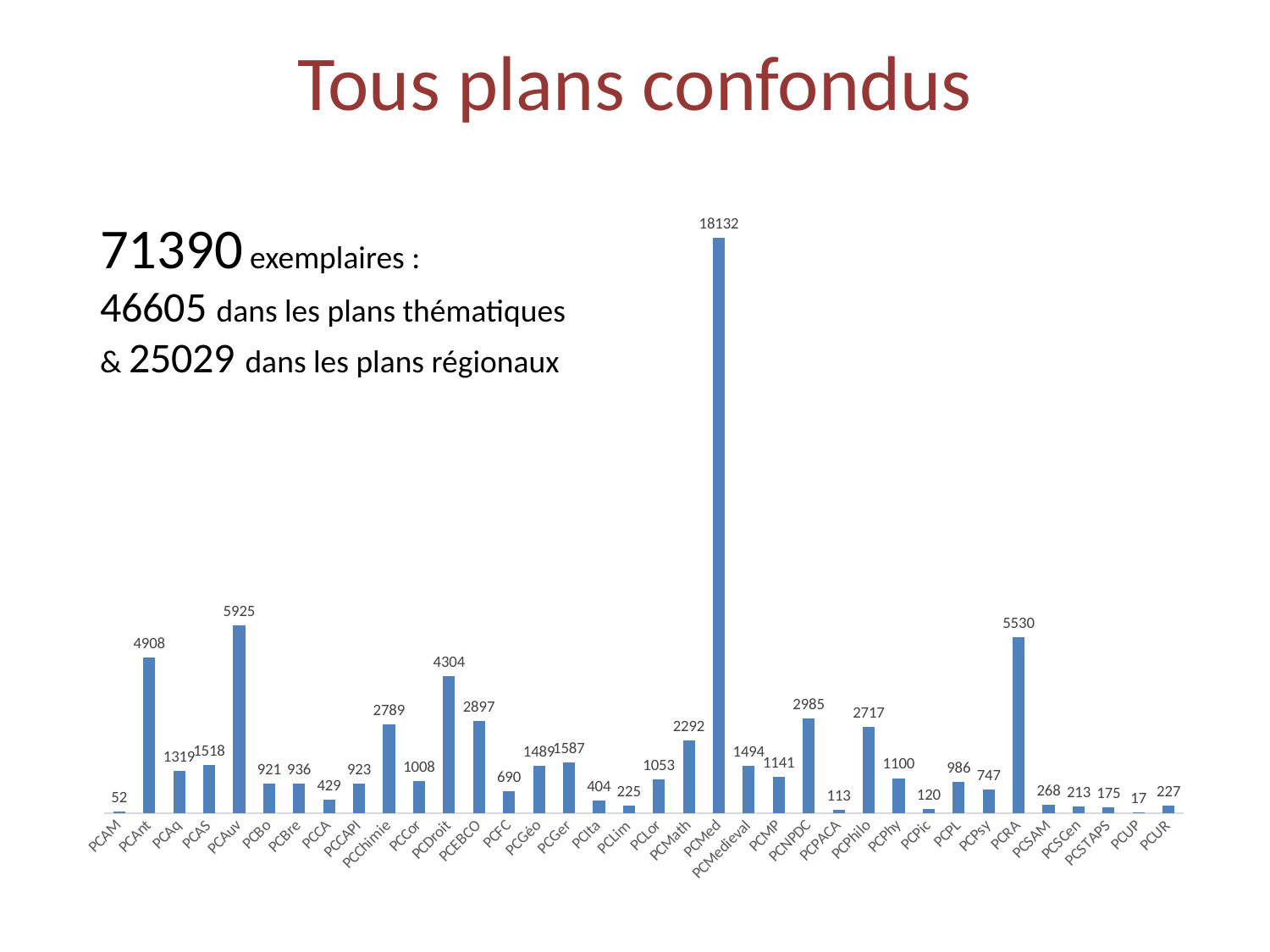
What is the difference between the values for PCAuv and PCRA? 395 What type of chart is shown on the slide? bar chart Which is larger, the value for PCNPDC or the value for PCPhilo? PCNPDC What is the value for PCAuv? 5925 Which category has the lowest value? PCUP What is the value for PCMed? 18132 What is the difference between the values for PCAnt and PCDroit? 604 Which category has the highest value? PCMed What is the value for PCDroit? 4304 What is the value for PCPACA? 113 What is the title of the chart on the slide? Tous plans confondus How many categories are shown on the x axis? 36